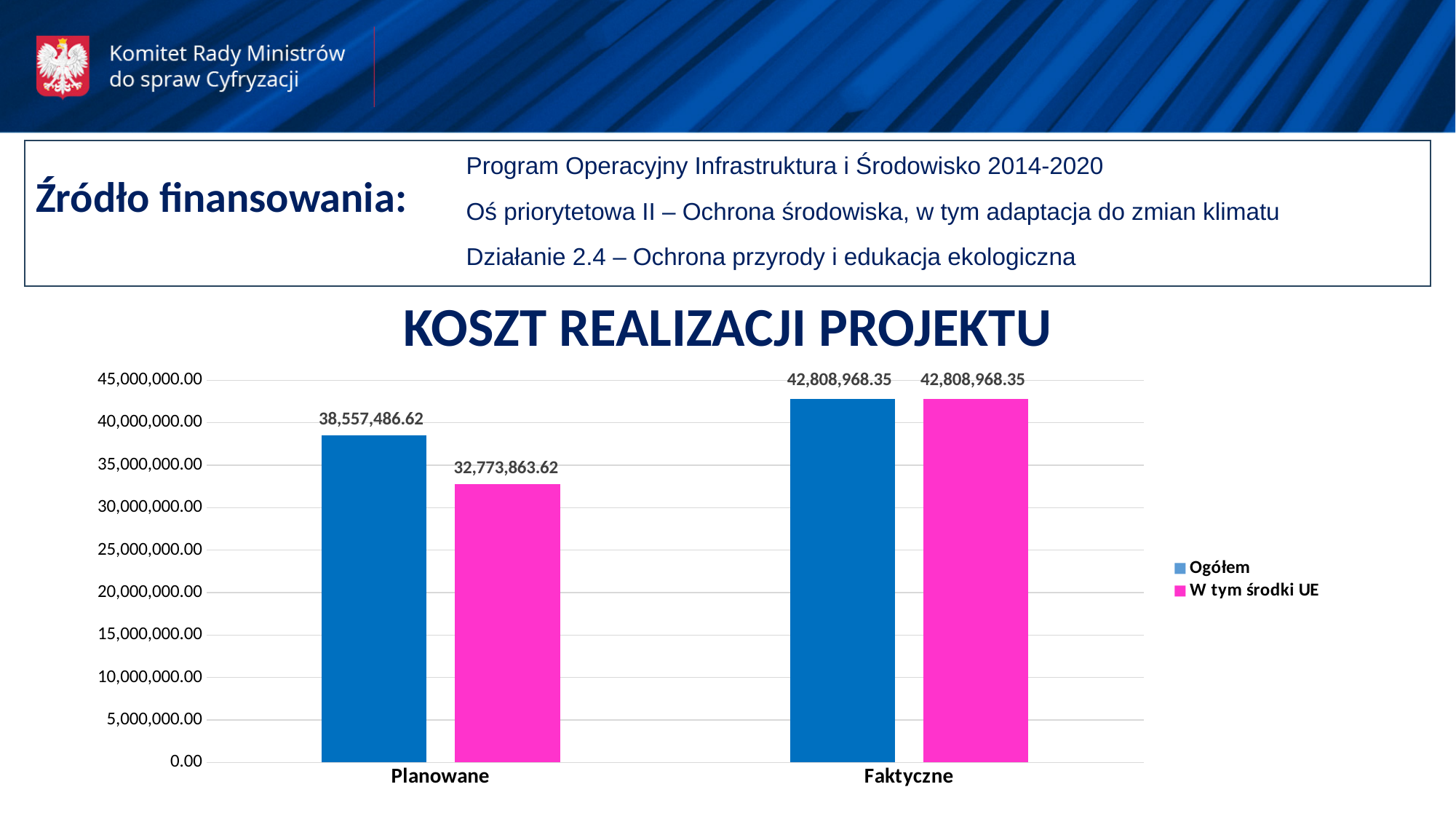
What is the difference between the Ogółem values for Faktyczne and Planowane? 4,251,481.73 What is the difference between Ogółem and W tym środki UE for Planowane? 5,783,623.00 How many categories are shown on the x axis? 2 How many series does the legend list? 2 Is the Ogółem value for Planowane larger or smaller than the W tym środki UE value for Planowane? larger Which category has the lowest value for W tym środki UE? Planowane What is the value of Ogółem for Faktyczne? 42,808,968.35 What is the value of Ogółem for Planowane? 38,557,486.62 What is the value of W tym środki UE for Faktyczne? 42,808,968.35 What is the value of W tym środki UE for Planowane? 32,773,863.62 Which category has the highest value for Ogółem? Faktyczne What type of chart is shown on the slide? bar chart